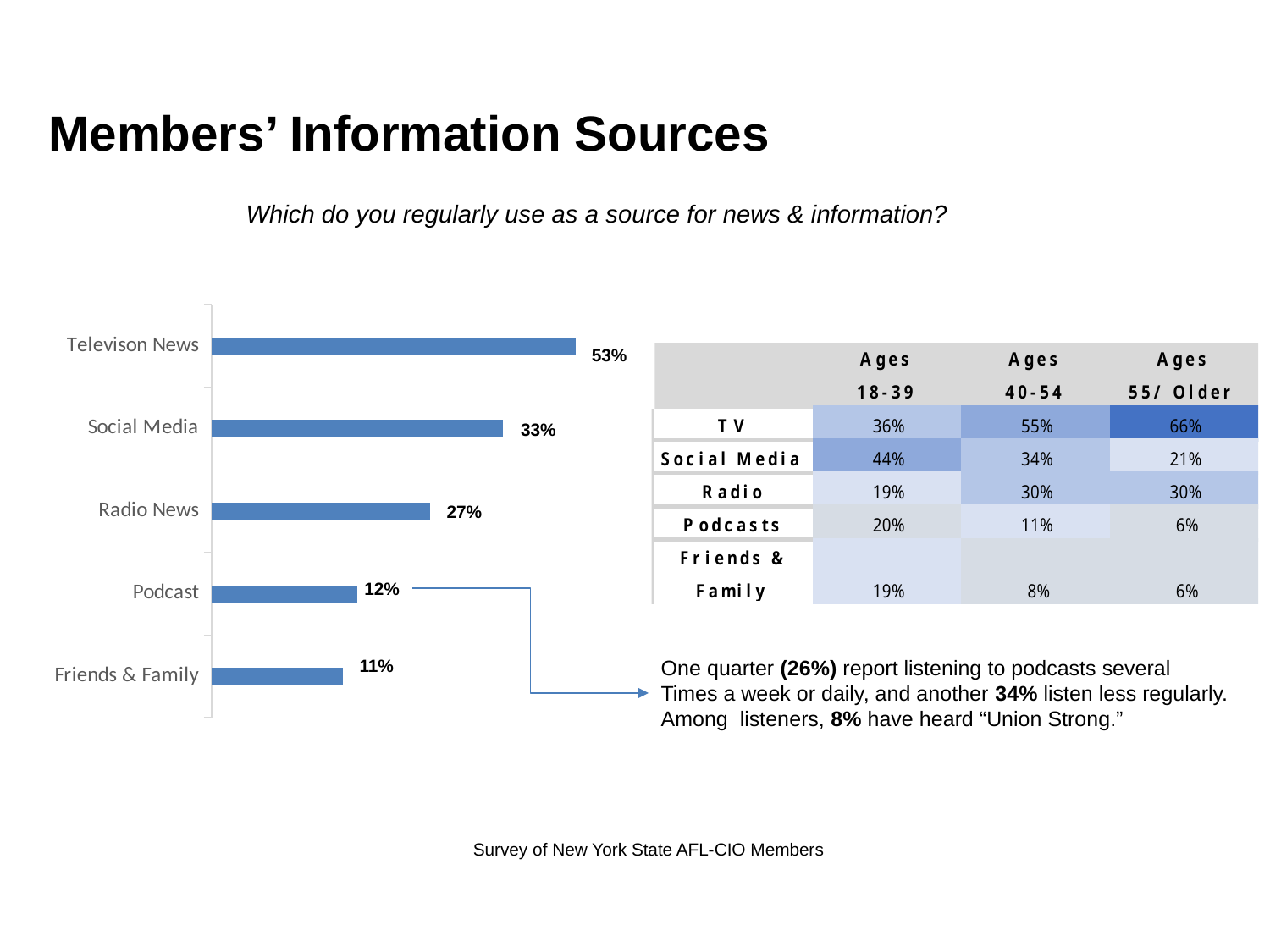
What is the value shown for Friends & Family in the bar chart? 11% What is the difference in percentage points between Podcast and Friends & Family in the bar chart? 1 Which has a larger value in the bar chart, Social Media or Radio News? Social Media What is the value shown for Radio News in the bar chart? 27% Which information source has the lowest value in the bar chart? Friends & Family What is the value shown for Social Media in the bar chart? 33% What type of chart is used to show members' information sources? Bar chart What is the difference in percentage points between Television News and Social Media in the bar chart? 20 What percentage of members regularly use Television News as a source for news & information? 53% Which information source has the highest value in the bar chart? Televison News What question is shown as the subtitle above the bar chart? Which do you regularly use as a source for news & information? How many information sources are shown in the bar chart? 5